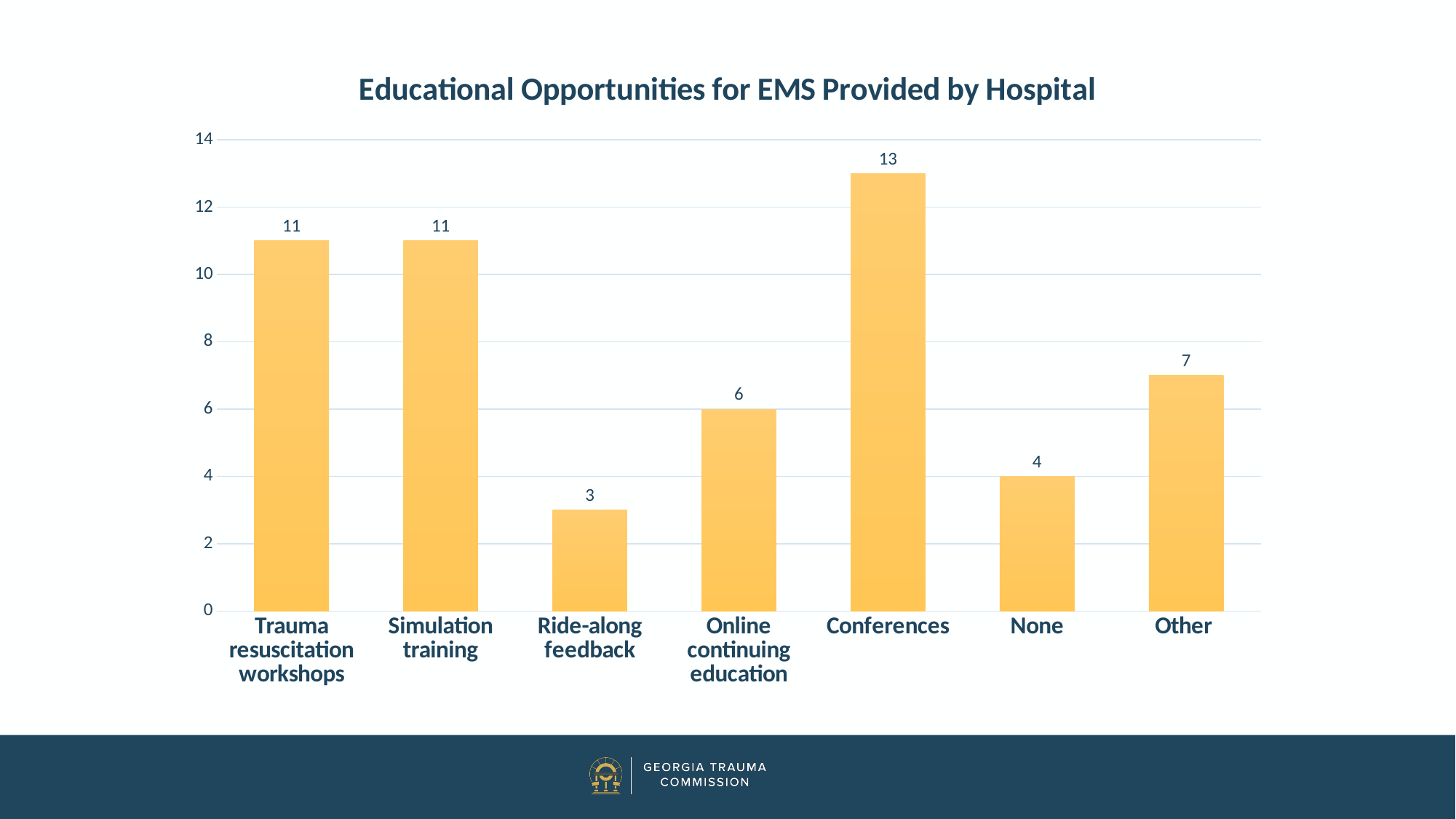
What is the value for Online continuing education? 6 What is the value for Ride-along feedback? 3 Which is larger, the value for Other or the value for Online continuing education? Other What is the difference between the values for Simulation training and None? 7 Which category has the lowest value? Ride-along feedback Which category has the highest value? Conferences What kind of chart is shown on the slide? Bar chart What is the value for None? 4 What is the difference between the values for Conferences and Other? 6 What is the title of the chart? Educational Opportunities for EMS Provided by Hospital How many categories are shown on the x axis? 7 What is the value for Conferences? 13